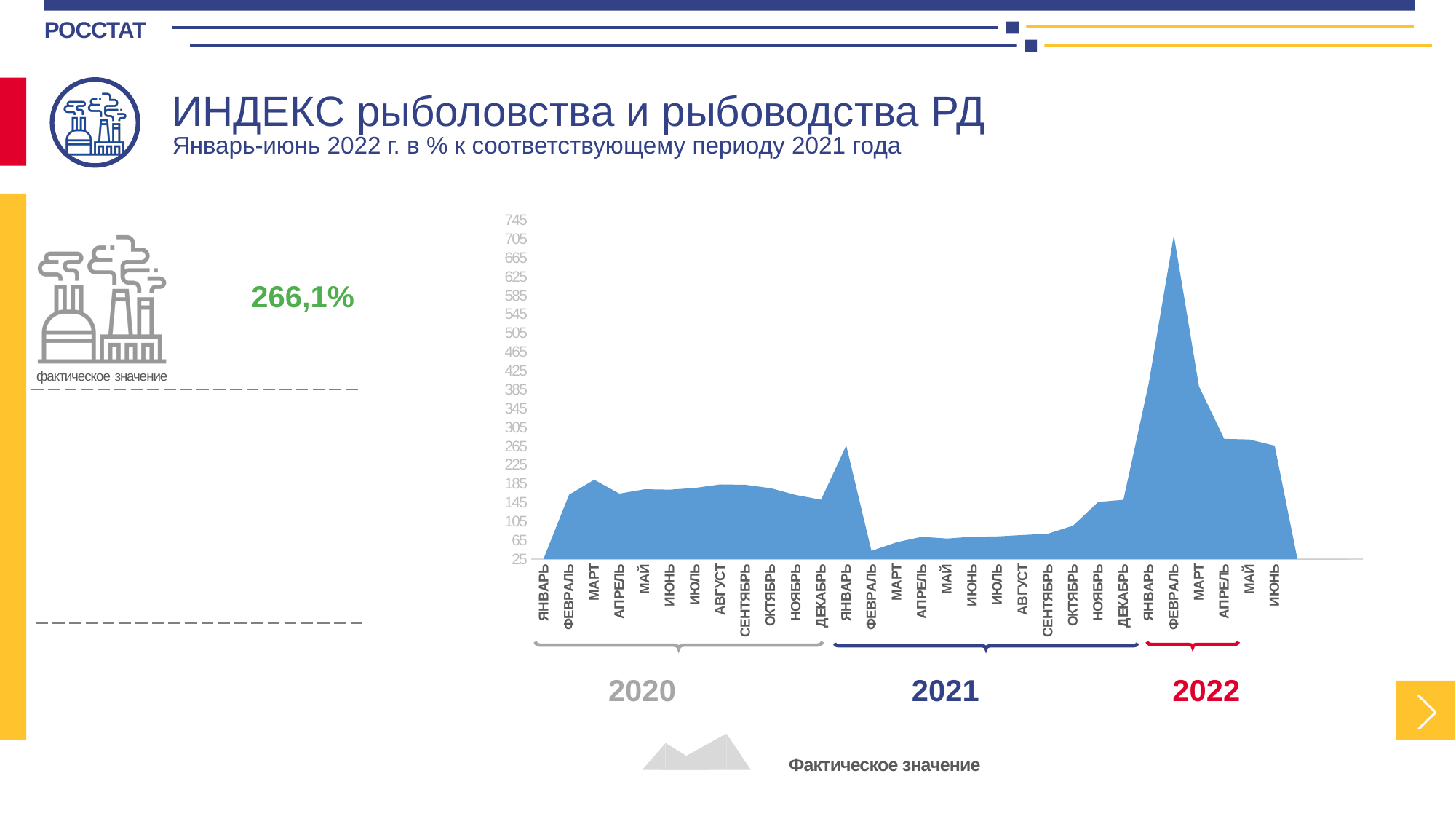
Which month has the highest value on the chart? Февраль 2022 How many monthly data points are plotted on the chart? 30 Do the values rise or fall from Февраль 2022 to Июнь 2022? fall What kind of chart is shown on the slide? area chart Is the value for Апрель 2022 greater or less than 225? greater What is the legend entry for the plotted series? Фактическое значение Is the value for Февраль 2021 greater or less than 65? less Is the value for Февраль 2022 greater or less than 665? greater How many series does the legend list? 1 How many years are marked with brackets under the x axis? 3 Which is larger, the value for Январь 2021 or the value for Март 2021? Январь 2021